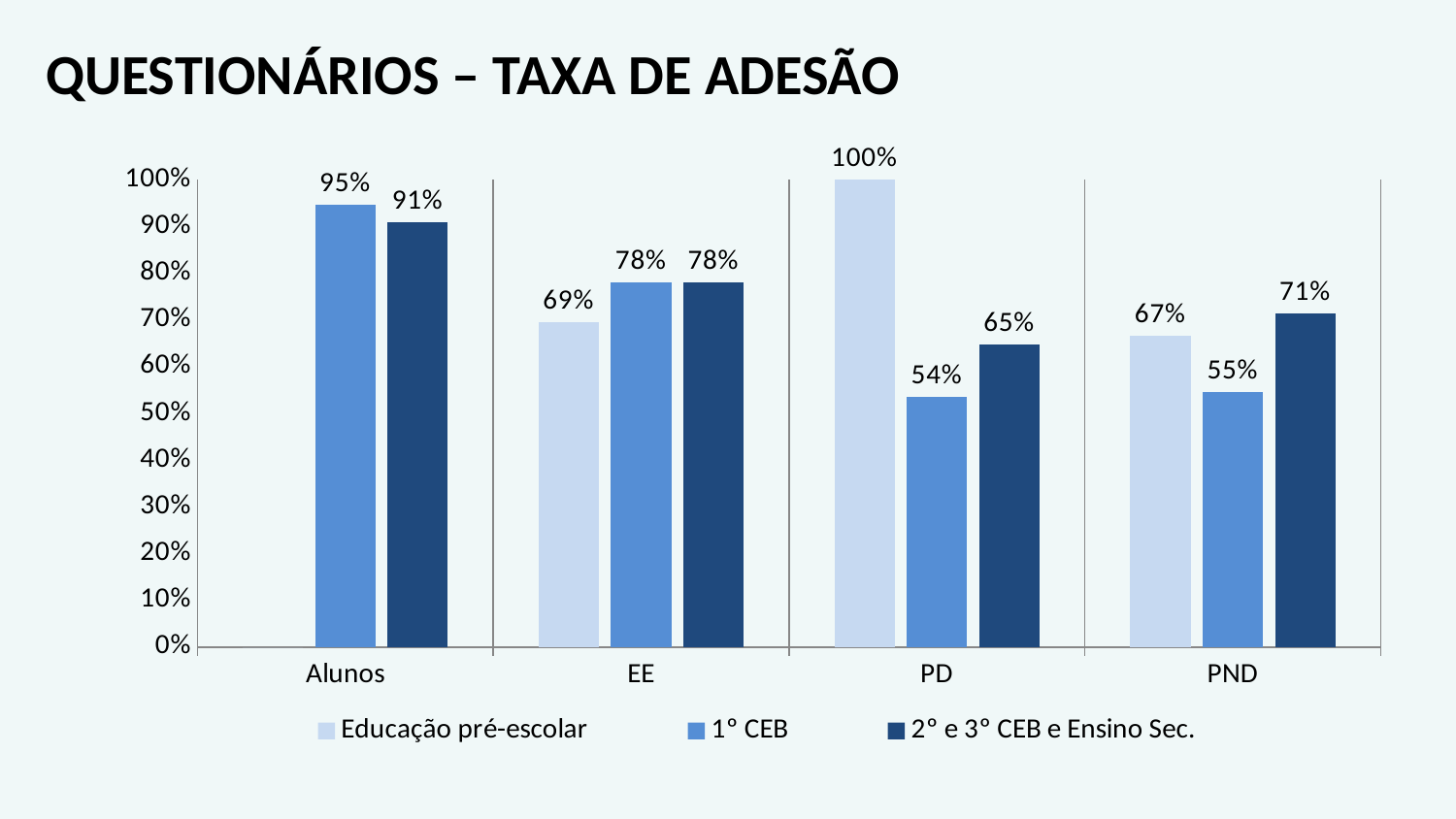
Is the value for 2° e 3° CEB e Ensino Sec. in the PD category greater or less than 60%? greater Which is larger in the EE category: Educação pré-escolar or 1° CEB? 1° CEB What is the value for Educação pré-escolar in the PD category? 100% How many series does the legend list? 3 What is the difference between the Educação pré-escolar and 1° CEB values in the PD category? 46% How many categories are shown on the x axis? 4 What is the value for 1° CEB in the Alunos category? 95% What is the value for 2° e 3° CEB e Ensino Sec. in the PND category? 71% Which category has the highest value for the 1° CEB series? Alunos What is the title of the slide? QUESTIONÁRIOS – TAXA DE ADESÃO Which category has the lowest value for the 1° CEB series? PD What kind of chart is shown on the slide? bar chart